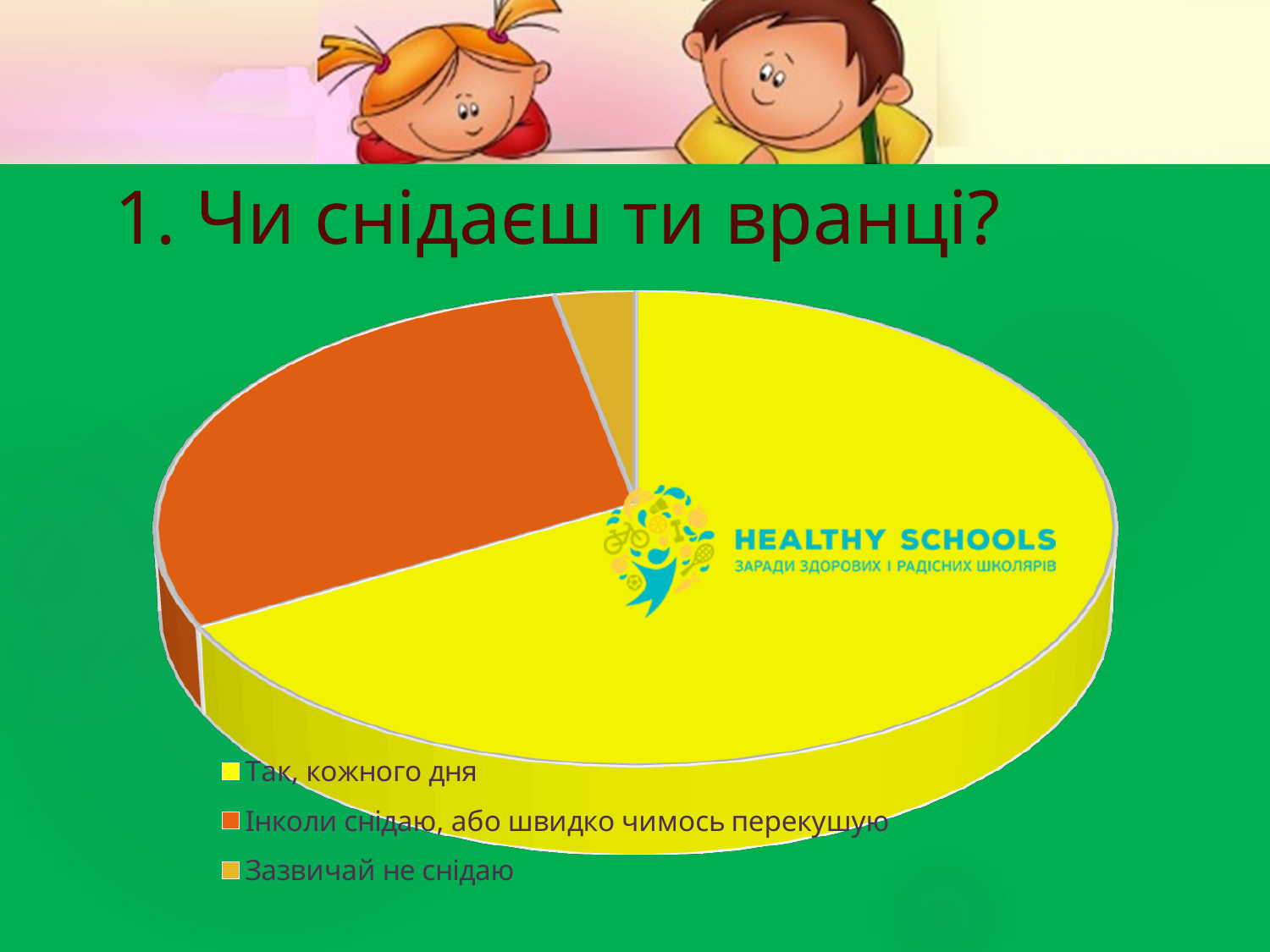
How many entries does the legend list? 3 How many slices does the pie chart have? 3 What kind of chart is shown on the slide? pie chart What is the title of the chart on the slide? 1. Чи снідаєш ти вранці? Which slice is larger: "Інколи снідаю, або швидко чимось перекушую" or "Зазвичай не снідаю"? Інколи снідаю, або швидко чимось перекушую What colour is the slice for "Інколи снідаю, або швидко чимось перекушую"? orange Which slice is larger: "Так, кожного дня" or "Інколи снідаю, або швидко чимось перекушую"? Так, кожного дня Which category has the largest slice of the pie? Так, кожного дня Which category has the smallest slice of the pie? Зазвичай не снідаю